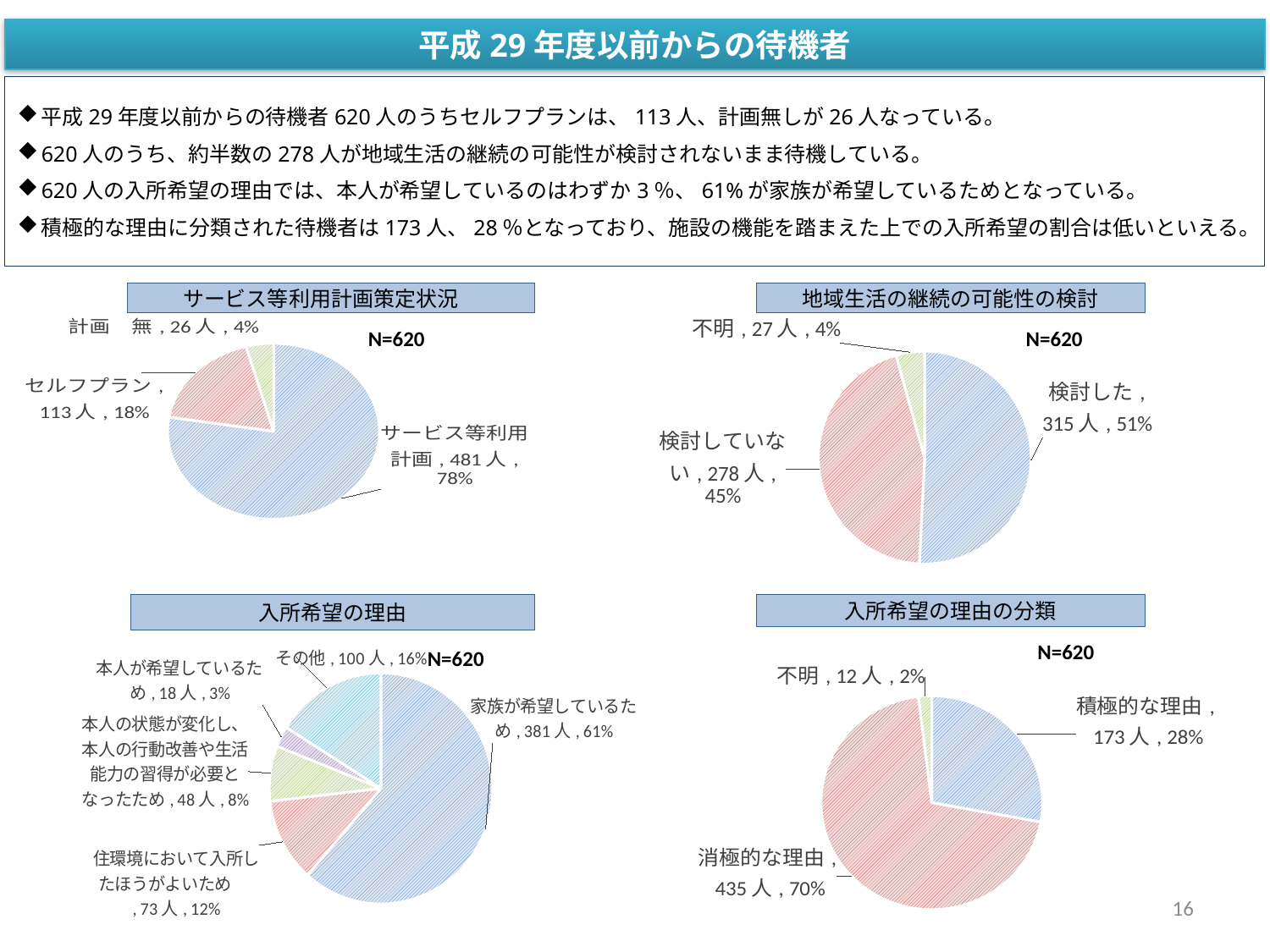
In the 「地域生活の継続の可能性の検討」 chart, what share of the pie is 「不明」? 4% In the 「入所希望の理由の分類」 chart, what share of the pie is 「消極的な理由」? 70% In the 「サービス等利用計画策定状況」 chart, what share of the pie is 「サービス等利用計画」? 78% In the 「地域生活の継続の可能性の検討」 chart, what is the difference in people between 「検討した」 and 「検討していない」? 37人 What type of chart is the 「入所希望の理由の分類」 chart? Pie chart In the 「サービス等利用計画策定状況」 chart, which category has the smallest slice? 計画無 In the 「入所希望の理由」 chart, which is larger: 「その他」 or 「住環境において入所したほうがよいため」? その他 In the 「入所希望の理由」 chart, which category has the largest slice? 家族が希望しているため In the 「入所希望の理由」 chart, how many categories are shown? 5 In the 「地域生活の継続の可能性の検討」 chart, how many people are in the 「検討していない」 slice? 278人 In the 「サービス等利用計画策定状況」 chart, how many people are in the 「セルフプラン」 slice? 113人 In the 「入所希望の理由」 chart, how many people are in the 「本人が希望しているため」 slice? 18人